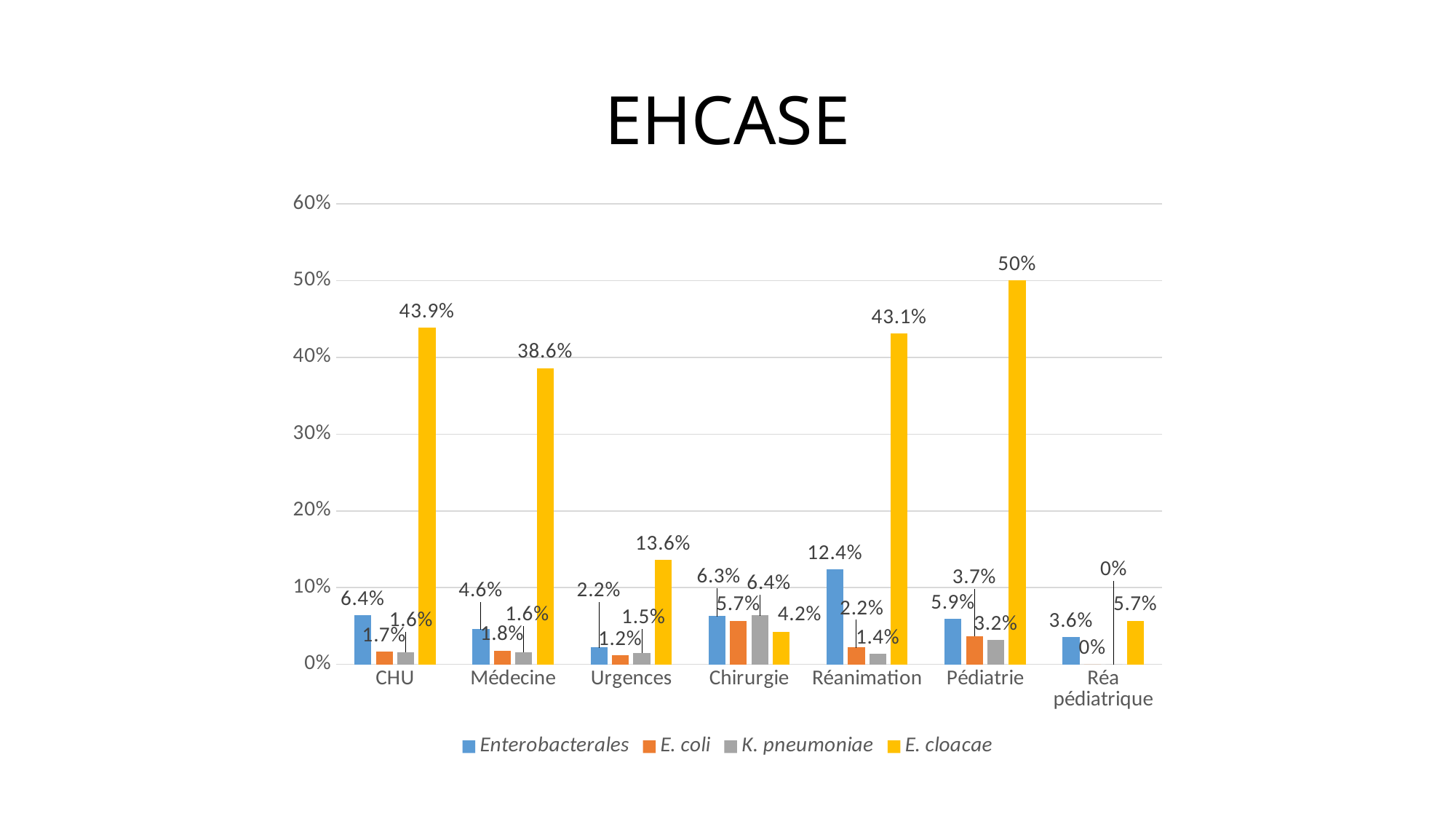
Which is larger, the E. cloacae value for CHU or for Réanimation? CHU Which category has the highest E. cloacae value? Pédiatrie What is the K. pneumoniae value for Urgences? 1.5% What is the difference between the E. cloacae values for CHU and Médecine? 5.3% Is the E. cloacae value for Urgences greater or less than 10%? greater What is the E. cloacae value for Pédiatrie? 50% How many series does the legend list? 4 How many categories are shown on the x axis? 7 Which category has the lowest Enterobacterales value? Urgences What is the Enterobacterales value for Réanimation? 12.4% What is the E. coli value for Chirurgie? 5.7% What type of chart is shown on the slide? Bar chart